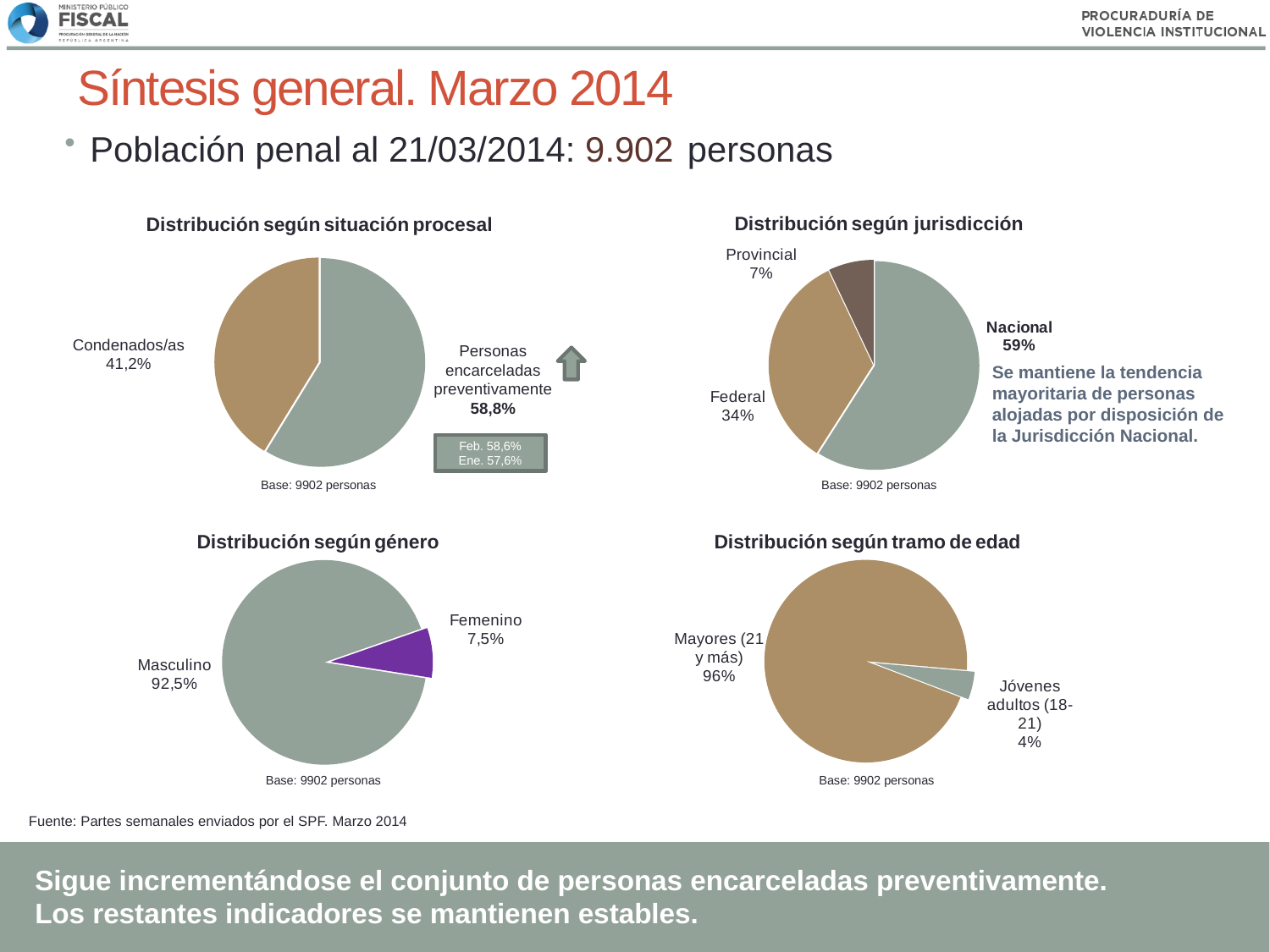
In the chart 'Distribución según género', what is the value for Femenino? 7,5% In the chart 'Distribución según situación procesal', what share is labelled for Personas encarceladas preventivamente? 58,8% In the chart 'Distribución según jurisdicción', what is the value for Federal? 34% What type of chart is 'Distribución según género'? Pie chart In the chart 'Distribución según jurisdicción', which category has the largest slice? Nacional In the chart 'Distribución según jurisdicción', which category has the smallest slice? Provincial In the chart 'Distribución según tramo de edad', what is the value for Jóvenes adultos (18-21)? 4% In the chart 'Distribución según tramo de edad', what is the value for Mayores (21 y más)? 96% In the chart 'Distribución según jurisdicción', what is the difference between the Nacional and Federal shares? 25% In the chart 'Distribución según jurisdicción', how many categories are shown? 3 In the chart 'Distribución según género', which is larger, Masculino or Femenino? Masculino In the chart 'Distribución según situación procesal', what share is labelled for Condenados/as? 41,2%